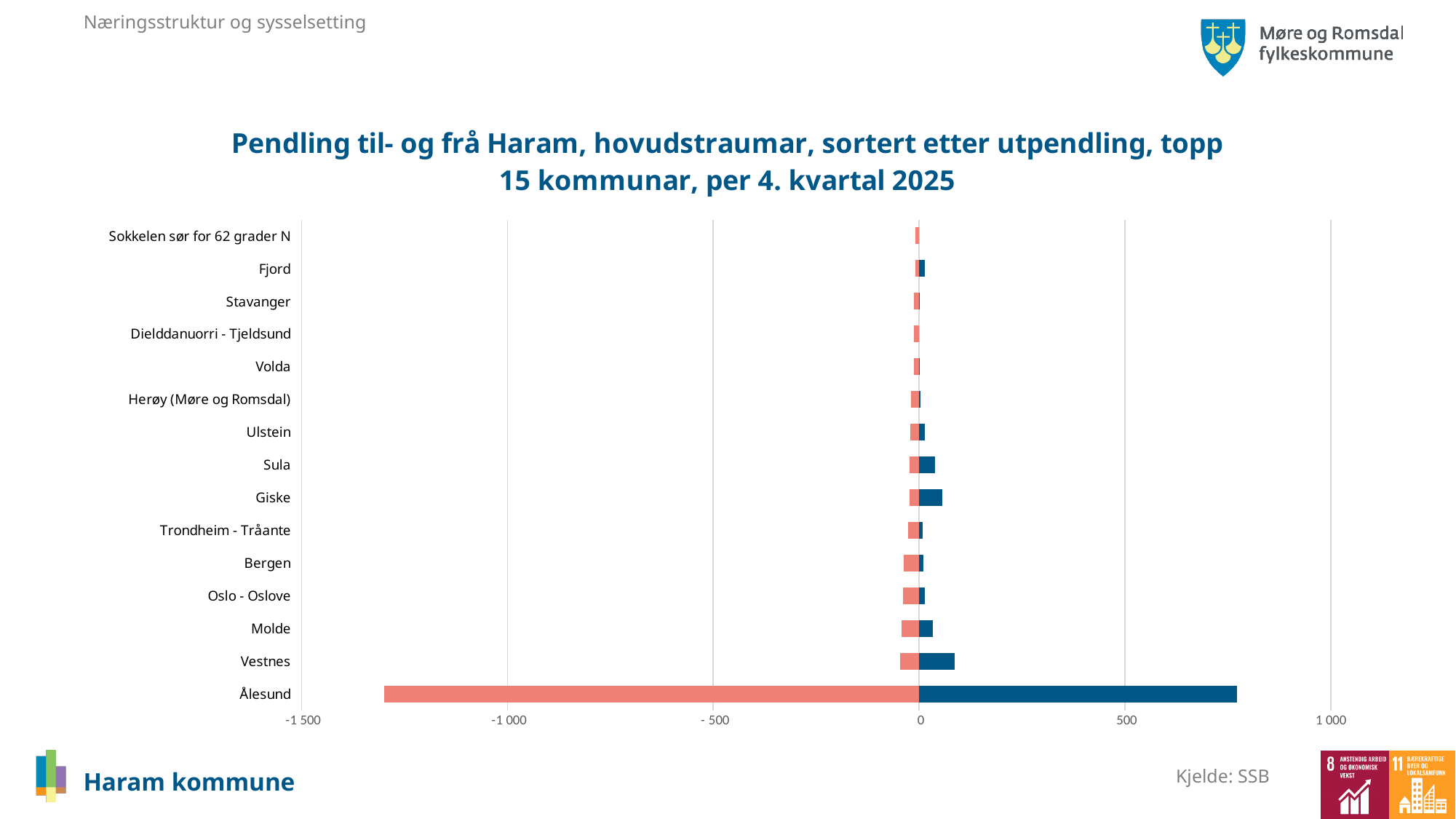
What kind of chart is shown on the slide? bar chart Which municipality is listed at the top of the chart? Sokkelen sør for 62 grader N How many municipalities (categories) are listed on the chart? 15 What is the lowest value shown on the horizontal axis? -1 500 Which municipality has the longest blue bar? Ålesund Is the red bar value for Ålesund greater or less than -1 000? less Which municipality has the longest red bar? Ålesund Is the blue bar value for Ålesund greater or less than 500? greater Which has the longer blue bar, Giske or Sula? Giske Which has the longer blue bar, Vestnes or Molde? Vestnes Is the blue bar value for Ålesund greater or less than 1 000? less